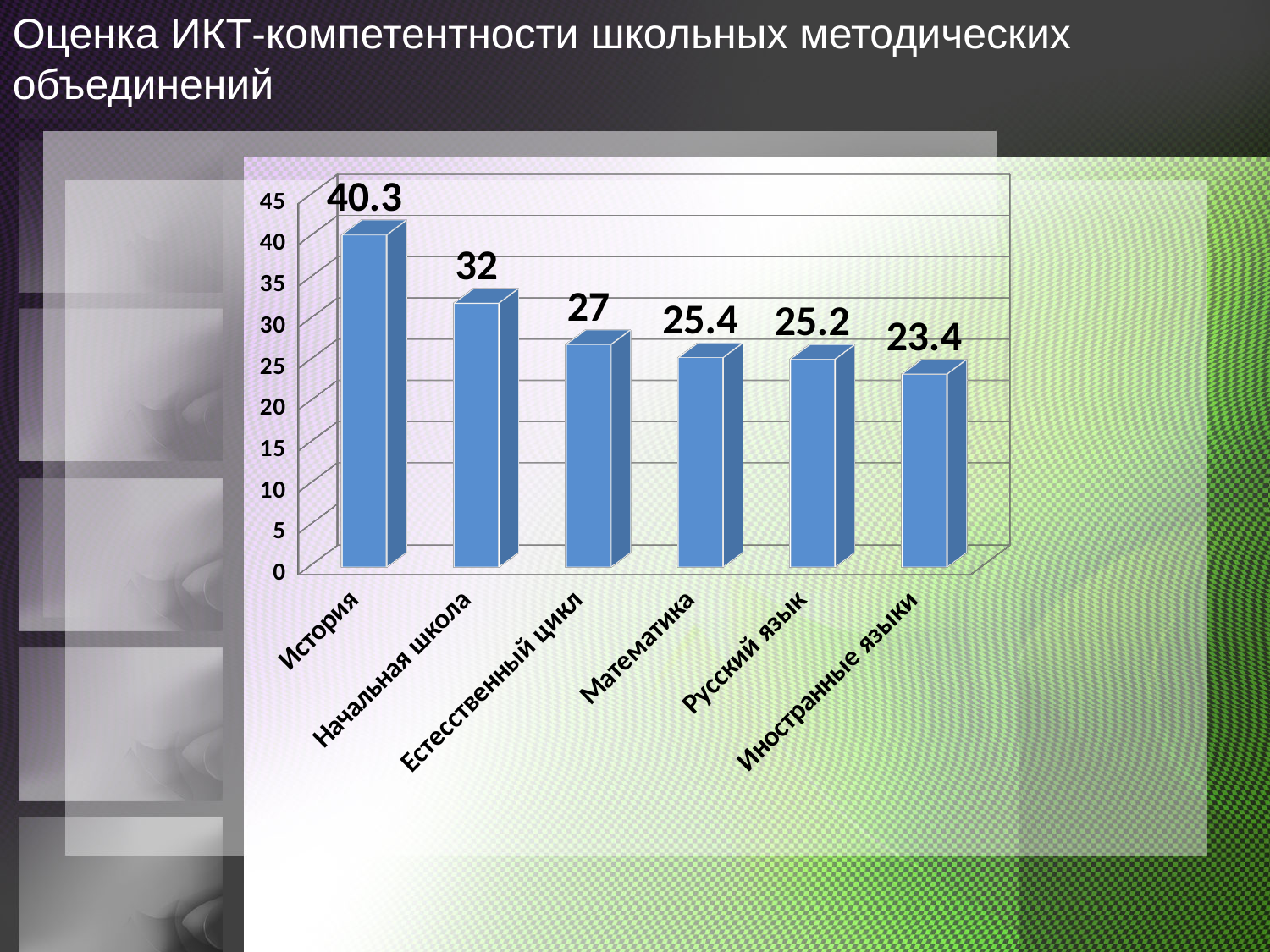
Which is larger, the value for Начальная школа or the value for Естественный цикл? Начальная школа What is the value for Математика? 25.4 Which category has the highest value? История What is the difference between the values for Естественный цикл and Иностранные языки? 3.6 What is the value for Начальная школа? 32 Which category has the lowest value? Иностранные языки Do the values rise or fall from left to right along the x axis? fall What is the value for Иностранные языки? 23.4 How many categories are shown on the chart? 6 What kind of chart is shown on the slide? bar chart What is the difference between the values for История and Начальная школа? 8.3 What is the value for История? 40.3